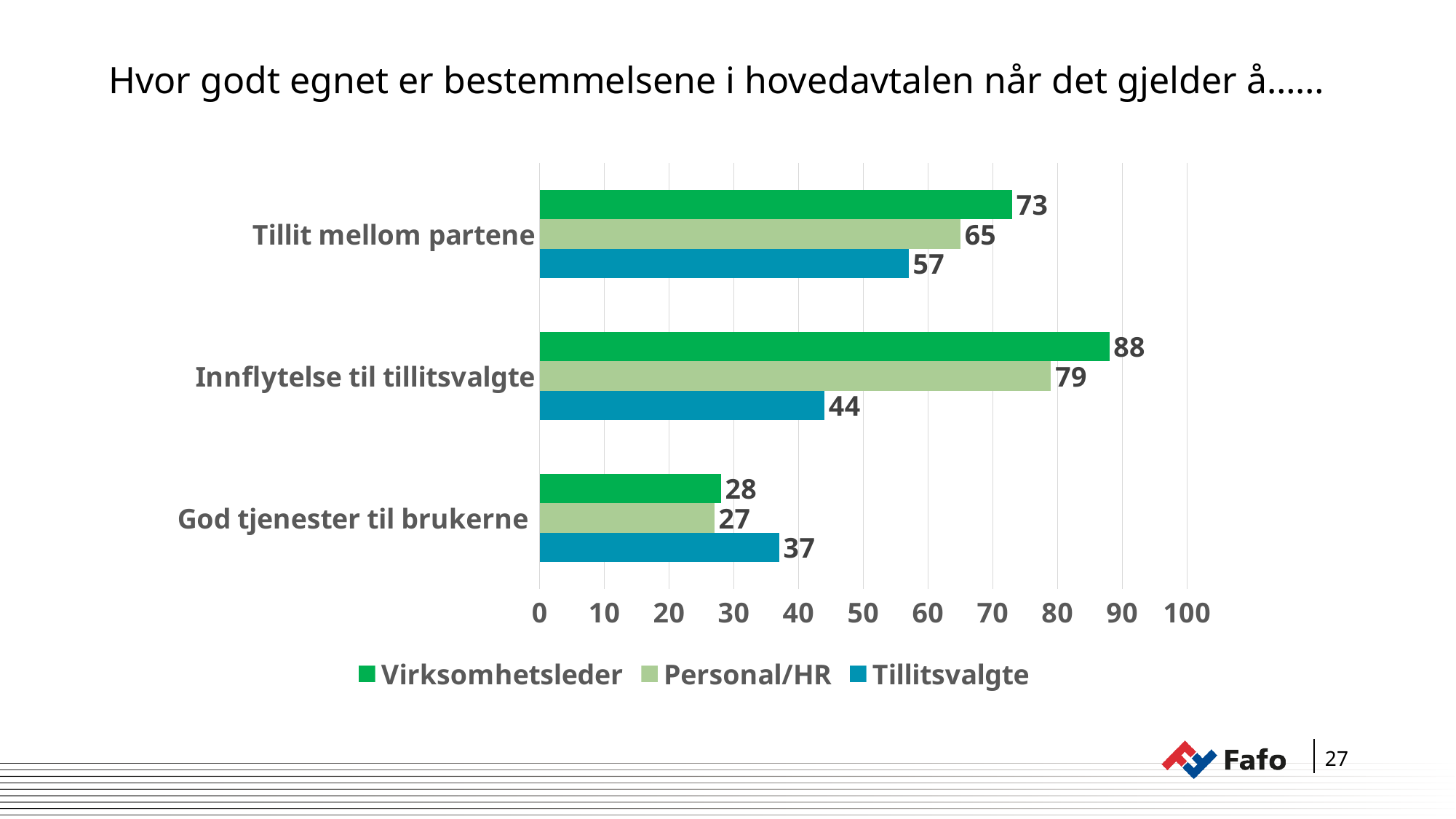
How many series does the legend list? 3 What kind of chart is shown on the slide? Bar chart What is the value for Tillitsvalgte for Tillit mellom partene? 57 Which category has the lowest value for Virksomhetsleder? God tjenester til brukerne What is the value for Personal/HR for God tjenester til brukerne? 27 What is the value for Virksomhetsleder for Innflytelse til tillitsvalgte? 88 What is the difference between the Virksomhetsleder and Tillitsvalgte values for Innflytelse til tillitsvalgte? 44 How many categories are shown on the chart? 3 Which category has the highest value for Tillitsvalgte? Tillit mellom partene For God tjenester til brukerne, which is larger: the Tillitsvalgte value or the Virksomhetsleder value? Tillitsvalgte Is the value for Personal/HR for Tillit mellom partene greater or less than 60? greater Which series is shown in blue in the legend? Tillitsvalgte